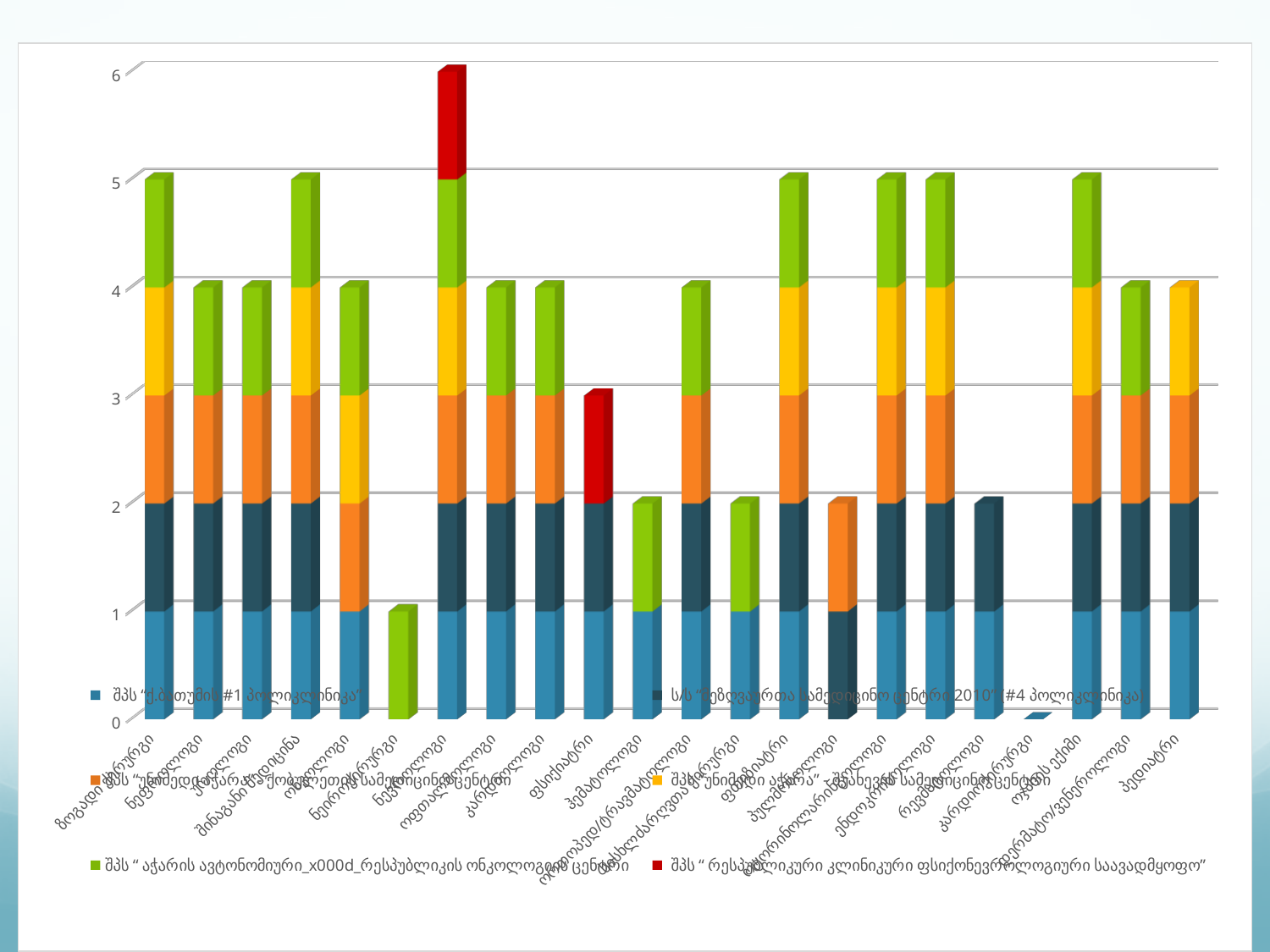
Is the total for ჰემატოლოგი greater or less than 3? less Which series is shown in red in the legend? შპს "რესპუბლიკური კლინიკური ფსიქონევროლოგიური საავადმყოფო" Which has the taller stacked bar, ფსიქიატრი or ფთიზიატრი? ფთიზიატრი Which category has the tallest stacked bar? ნევროლოგი What is the total height of the stacked bar for ფსიქიატრი? 3 How many series does the legend list? 6 What is the difference between the stacked totals for ნეფროლოგი and ჰემატოლოგი? 2 What is the total height of the stacked bar for ნეფროლოგი? 4 Is the total for ოჯახის ექიმი greater or less than 4? greater What is the total height of the stacked bar for ნეიროქირურგი? 1 What kind of chart is shown on the slide? stacked bar chart Which has the taller stacked bar, ზოგადი ქირურგი or ნევროლოგი? ნევროლოგი